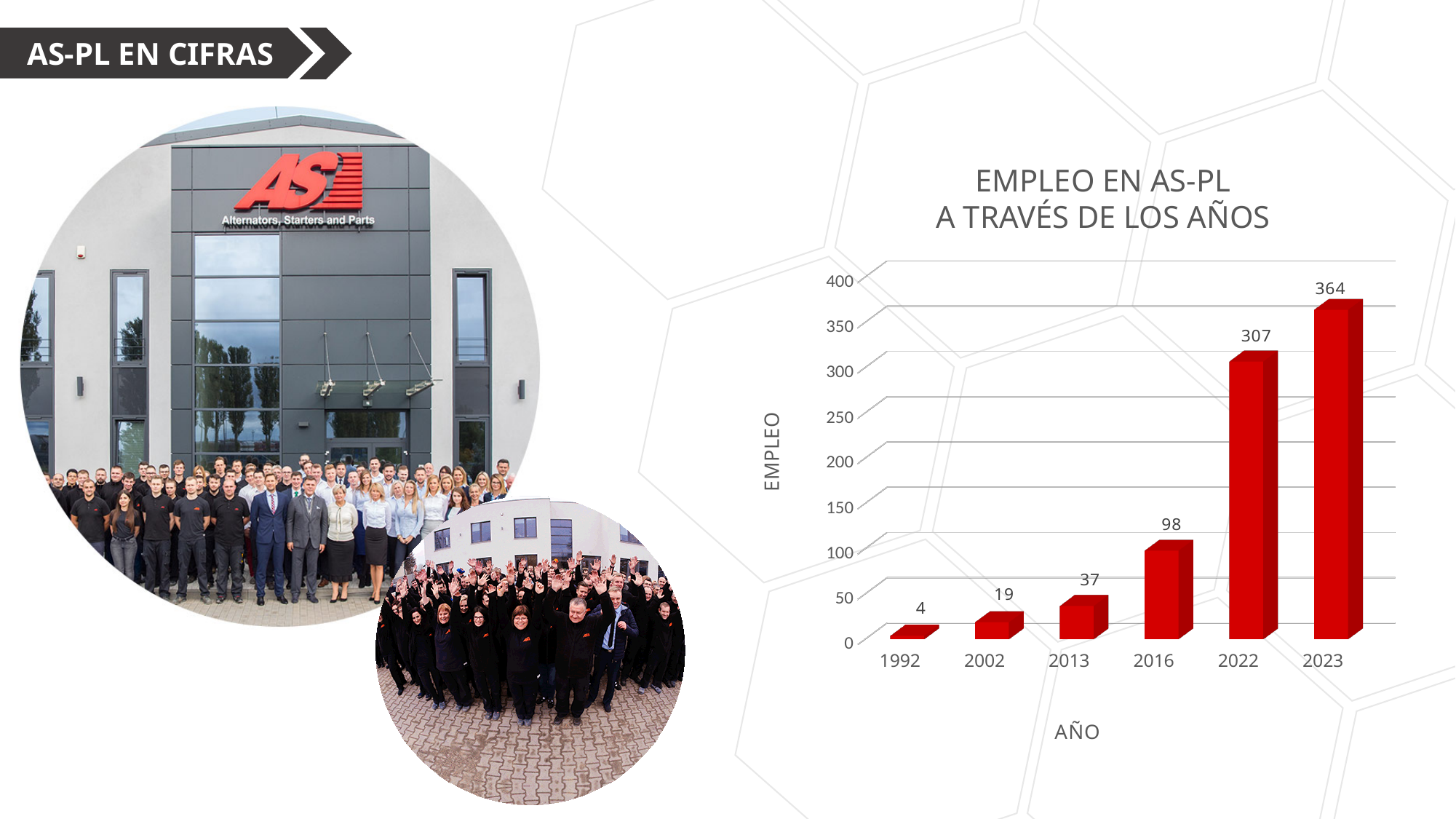
How many years are shown on the x axis of the chart? 6 Is the value for 2022 greater or less than 300? greater What is the difference between the employment values for 2023 and 2022? 57 What kind of chart is shown on the slide? bar chart Which year has the lowest employment value? 1992 Which year has the highest employment value? 2023 Which is larger, the value for 2013 or the value for 2016? 2016 What is the employment value for 2016? 98 What is the employment value for 2022? 307 Do the employment values rise or fall from 1992 to 2023? rise What is the employment value for 1992? 4 What is the difference between the employment values for 2013 and 2002? 18